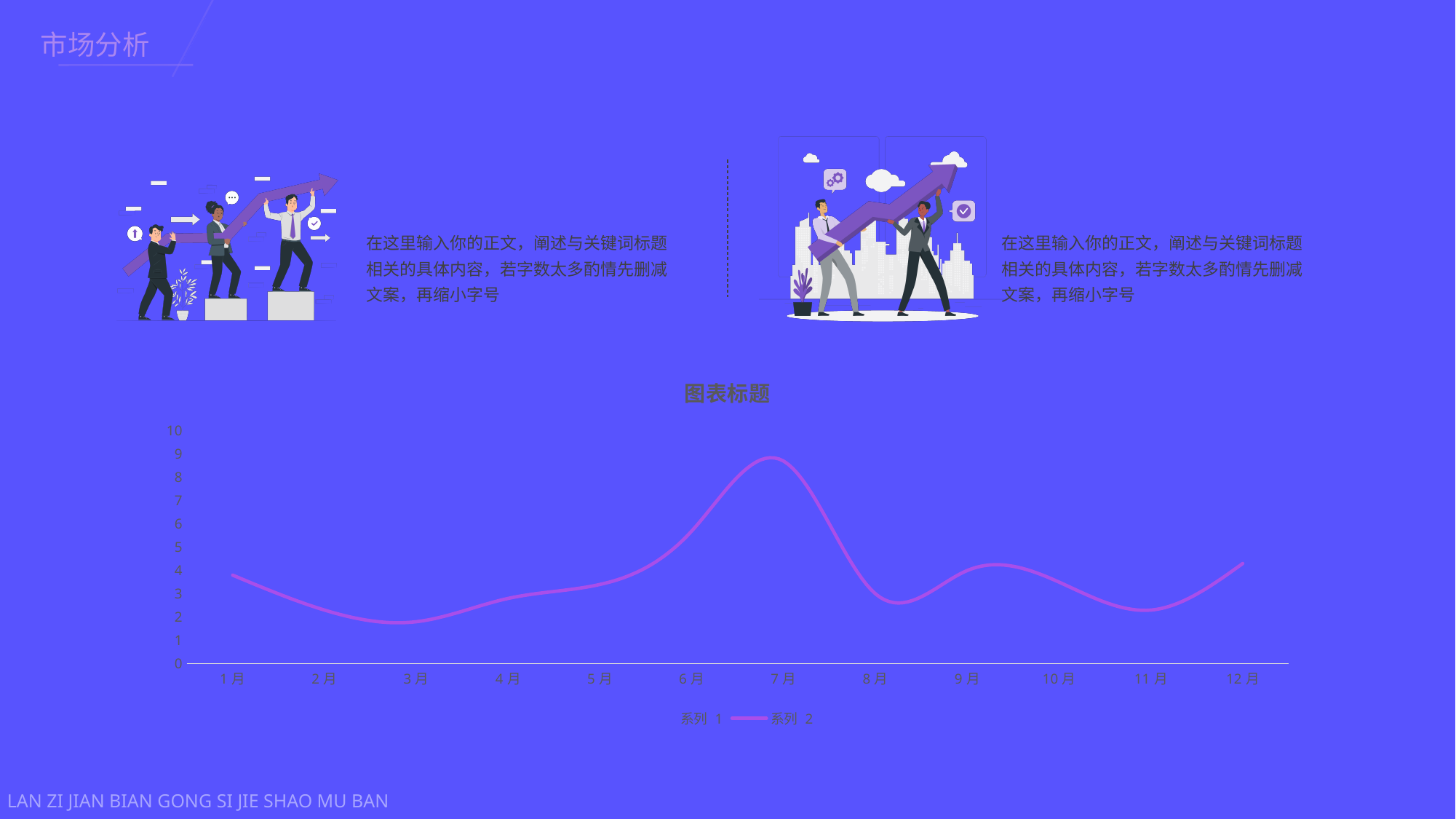
How many series does the chart legend list? 2 Is the value for 8月 greater or less than 4? less Is the value for 7月 greater or less than 8? greater Which month has the highest value on the line? 7月 What kind of chart is shown on the slide? line chart Does the line rise or fall from 7月 to 8月? fall Is the value for 3月 greater or less than 3? less Which is larger, the value for 1月 or the value for 3月? 1月 How many months are shown on the x axis of the chart? 12 What is the title of the chart? 图表标题 Which is larger, the value for 7月 or the value for 9月? 7月